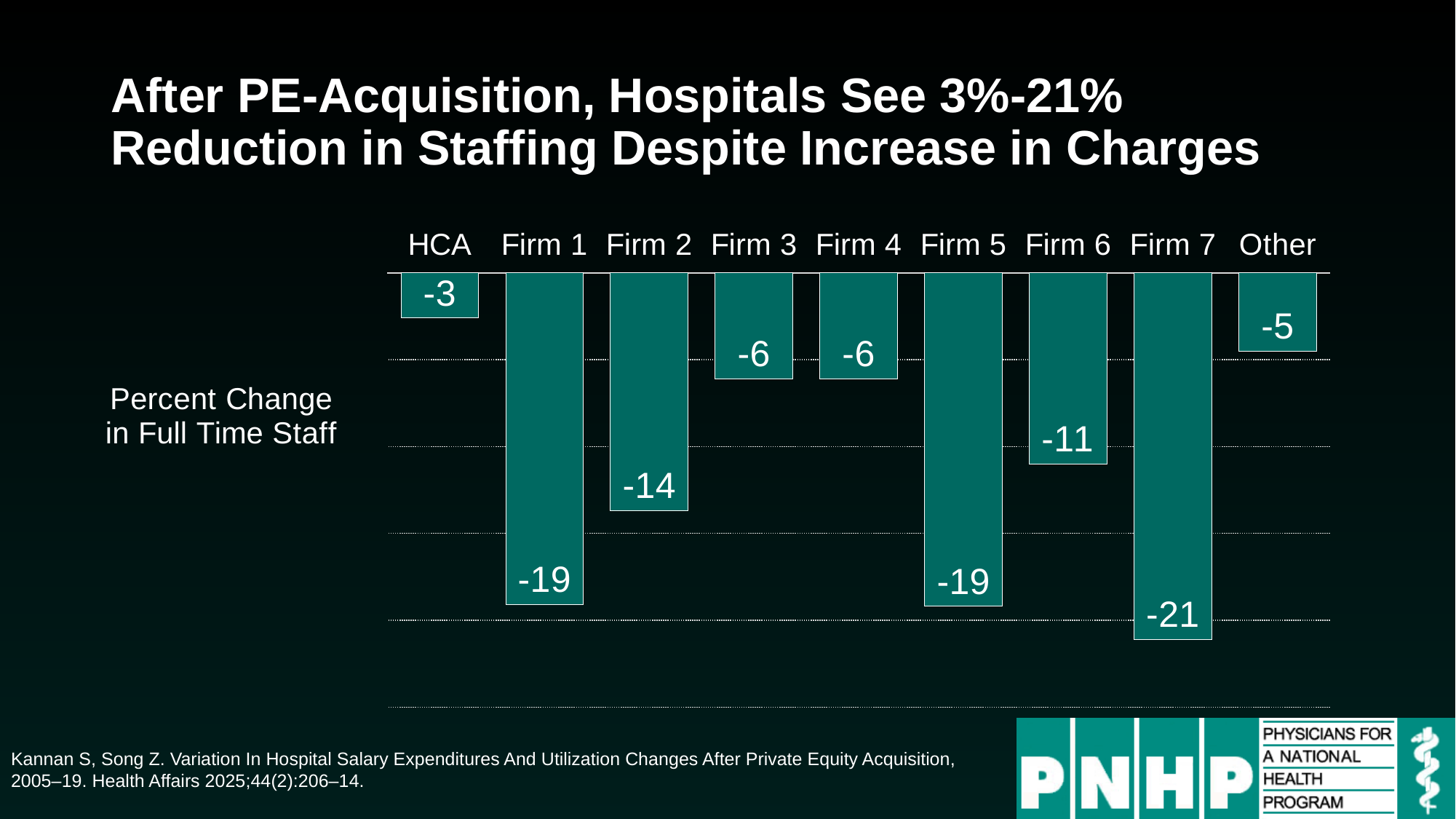
What is the percent change in full time staff for Firm 6? -11 What does the axis label to the left of the chart say? Percent Change in Full Time Staff Which two firms both have a value of -19? Firm 1 and Firm 5 What kind of chart is shown on the slide? Bar chart What is the difference between the values for Firm 7 and Firm 2? 7 What is the percent change in full time staff for Firm 2? -14 Which category shows the largest reduction in full time staff? Firm 7 What is the percent change in full time staff for HCA? -3 Which has a larger reduction in full time staff, Firm 6 or Firm 3? Firm 6 How many categories are shown on the chart? 9 Which category shows the smallest reduction in full time staff? HCA What is the percent change in full time staff for Other? -5